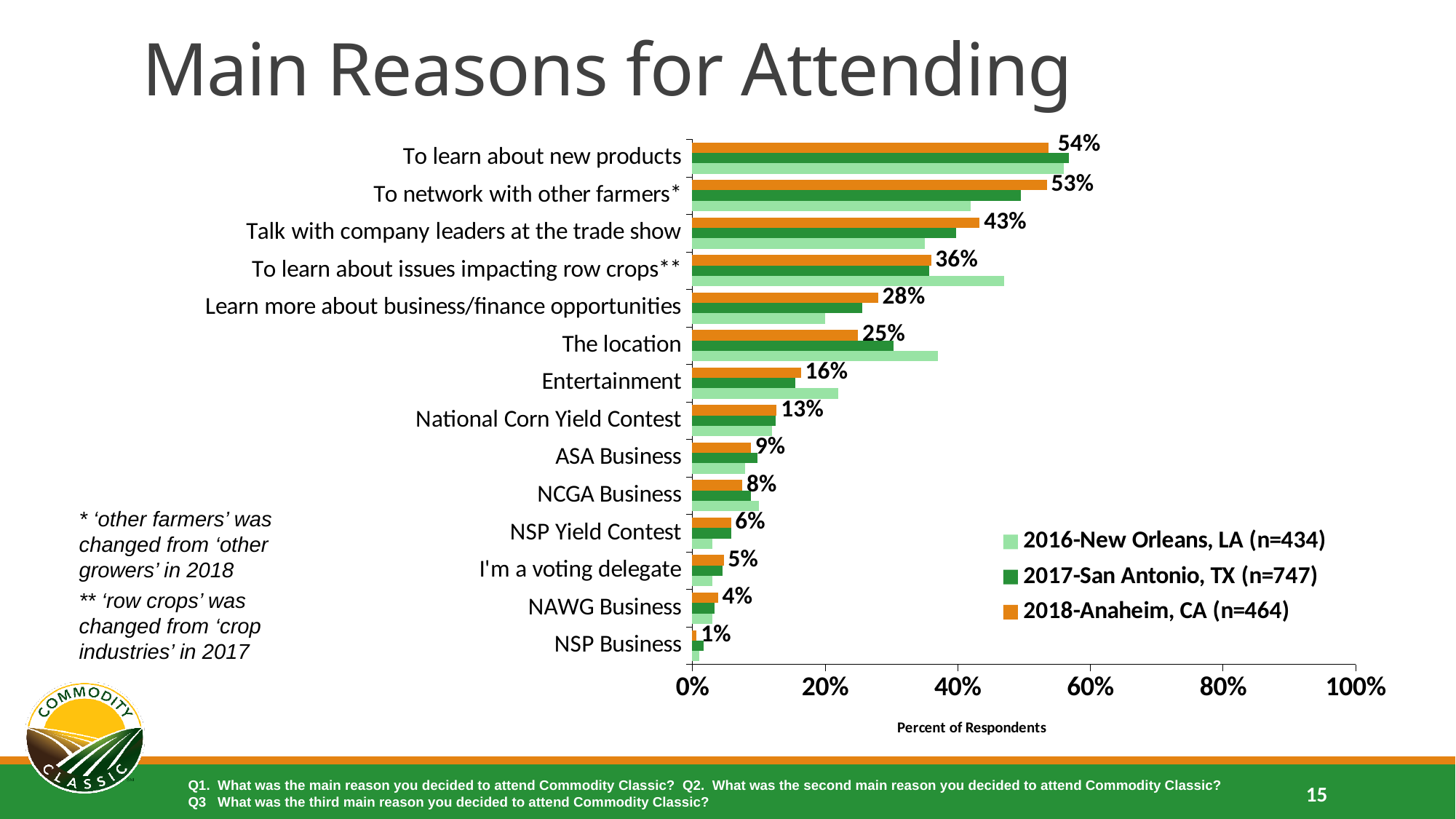
What is the 2018-Anaheim, CA value for 'Entertainment'? 16% Which reason has the highest 2018-Anaheim, CA value? To learn about new products What is the 2018-Anaheim, CA value for 'The location'? 25% How many series does the legend list? 3 What is the title of the horizontal axis? Percent of Respondents For 2018-Anaheim, CA, which is larger: 'The location' or 'Entertainment'? The location How many reasons (categories) are listed on the chart? 14 What kind of chart is shown on the slide? Bar chart Is the 2016-New Orleans, LA value for 'To learn about issues impacting row crops' greater or less than 40%? greater What is the 2018-Anaheim, CA value for 'To learn about new products'? 54% Which reason has the lowest 2018-Anaheim, CA value? NSP Business What is the difference between the 2018-Anaheim, CA values for 'To learn about new products' and 'Talk with company leaders at the trade show'? 11 percentage points